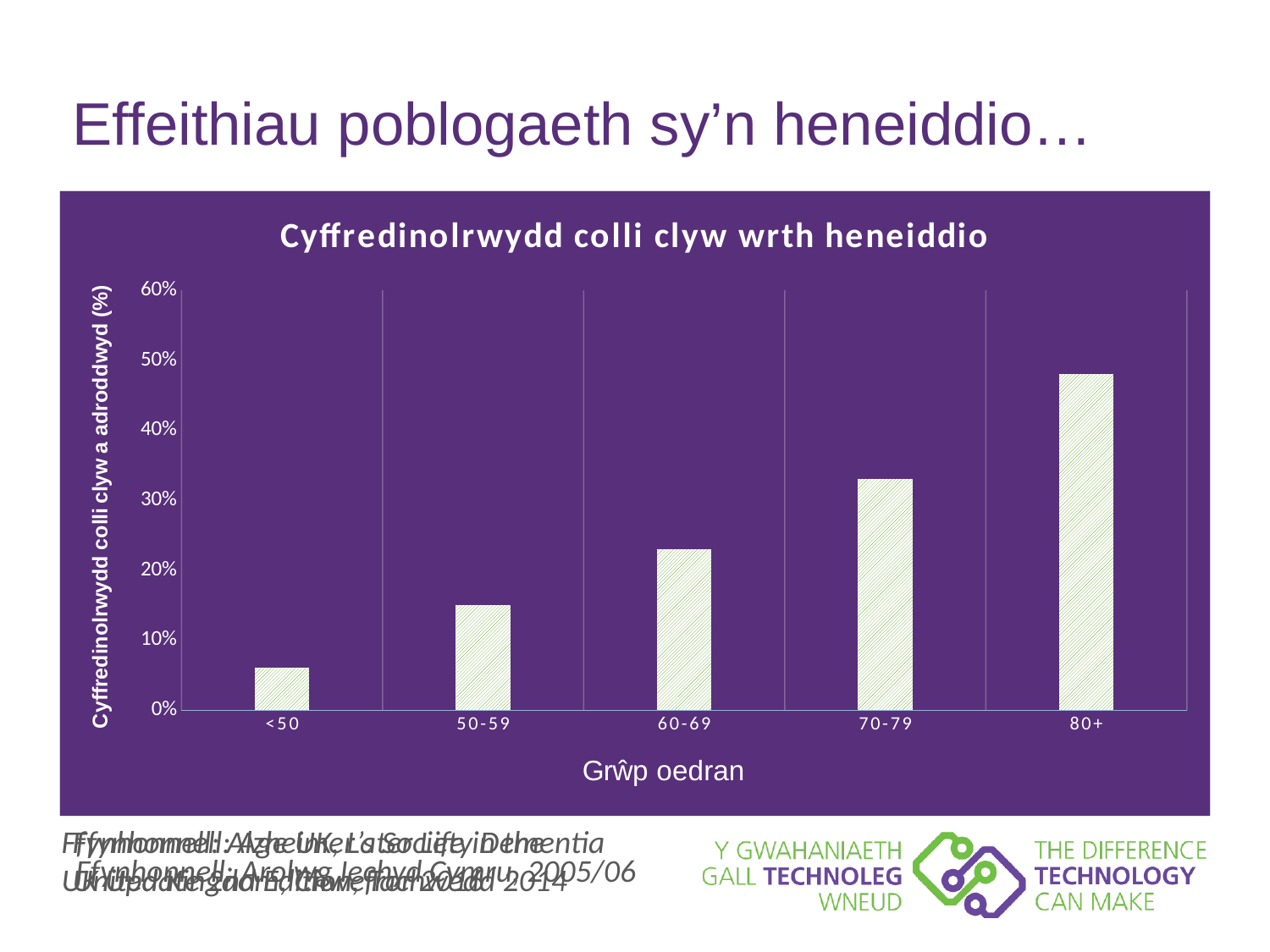
Is the value for the 80+ age group greater or less than 40%? greater Is the value for the <50 age group greater or less than 10%? less How many age groups are shown on the x axis of the chart? 5 Is the value for the 50-59 age group greater or less than 20%? less What kind of chart is shown on the slide? bar chart What is the title of the chart? Cyffredinolrwydd colli clyw wrth heneiddio Which age group has the lowest prevalence of hearing loss in the chart? <50 Which age group has a larger value, 70-79 or 80+? 80+ Do the values rise or fall as the age group increases along the x axis? rise Which age group has the highest prevalence of hearing loss in the chart? 80+